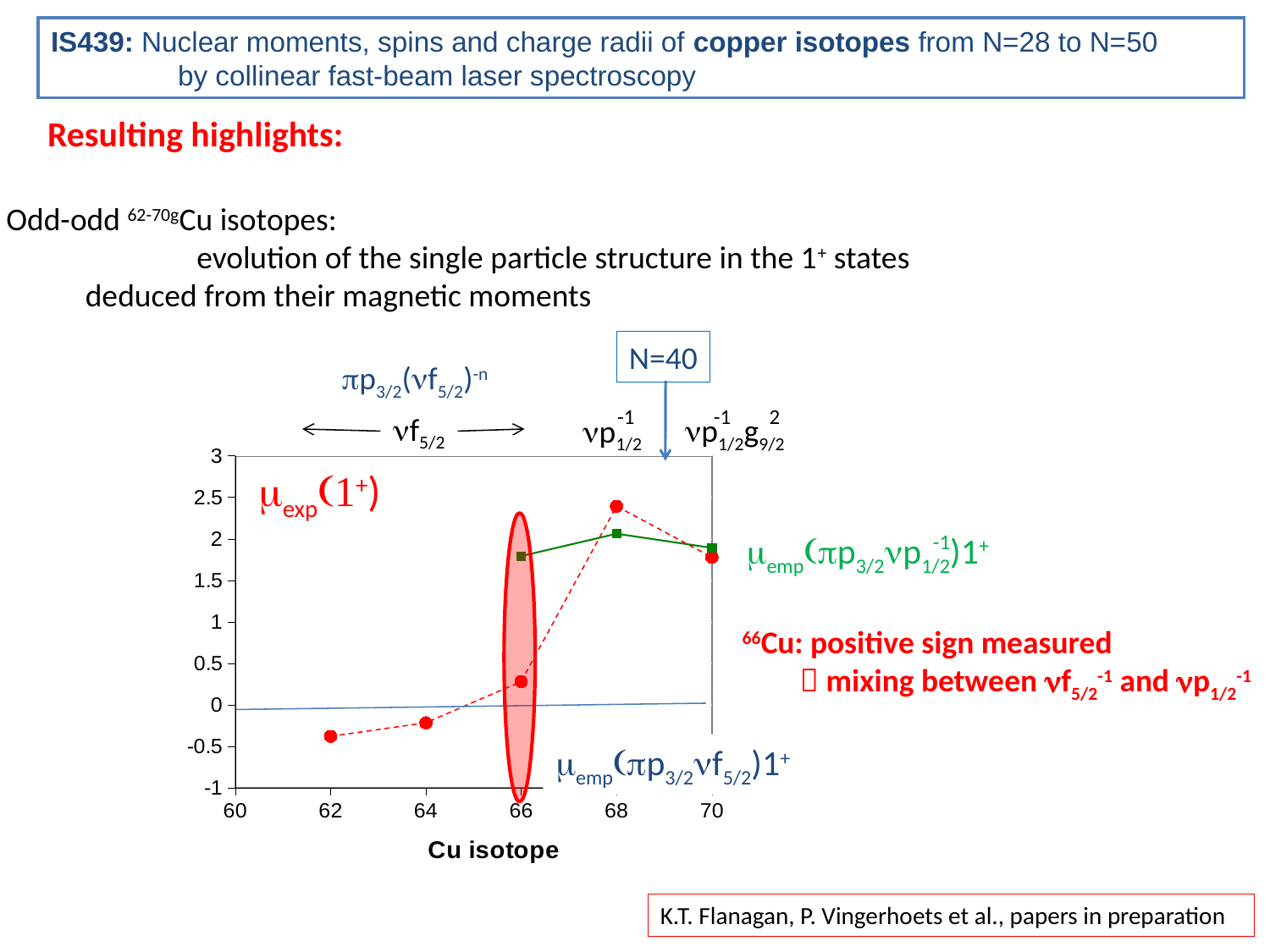
What kind of chart is shown on the slide? line chart Do the red μexp(1+) values rise or fall from Cu isotope 62 to 68? rise At which Cu isotope is the red μexp(1+) value highest? 68 How many red circle data points (μexp(1+)) are plotted on the chart? 5 Which has the larger red μexp(1+) value, Cu isotope 68 or Cu isotope 70? 68 At which Cu isotope is the red μexp(1+) value lowest? 62 Is the red μexp(1+) value for Cu isotope 62 greater or less than 0? less Is the red μexp(1+) value for Cu isotope 66 greater or less than 0.5? less At Cu isotope 66, which is larger, the green square value or the red circle value? green square How many green square data points are plotted on the chart? 3 Is the red μexp(1+) value for Cu isotope 68 greater or less than 2? greater What is the title of the x axis of the chart? Cu isotope